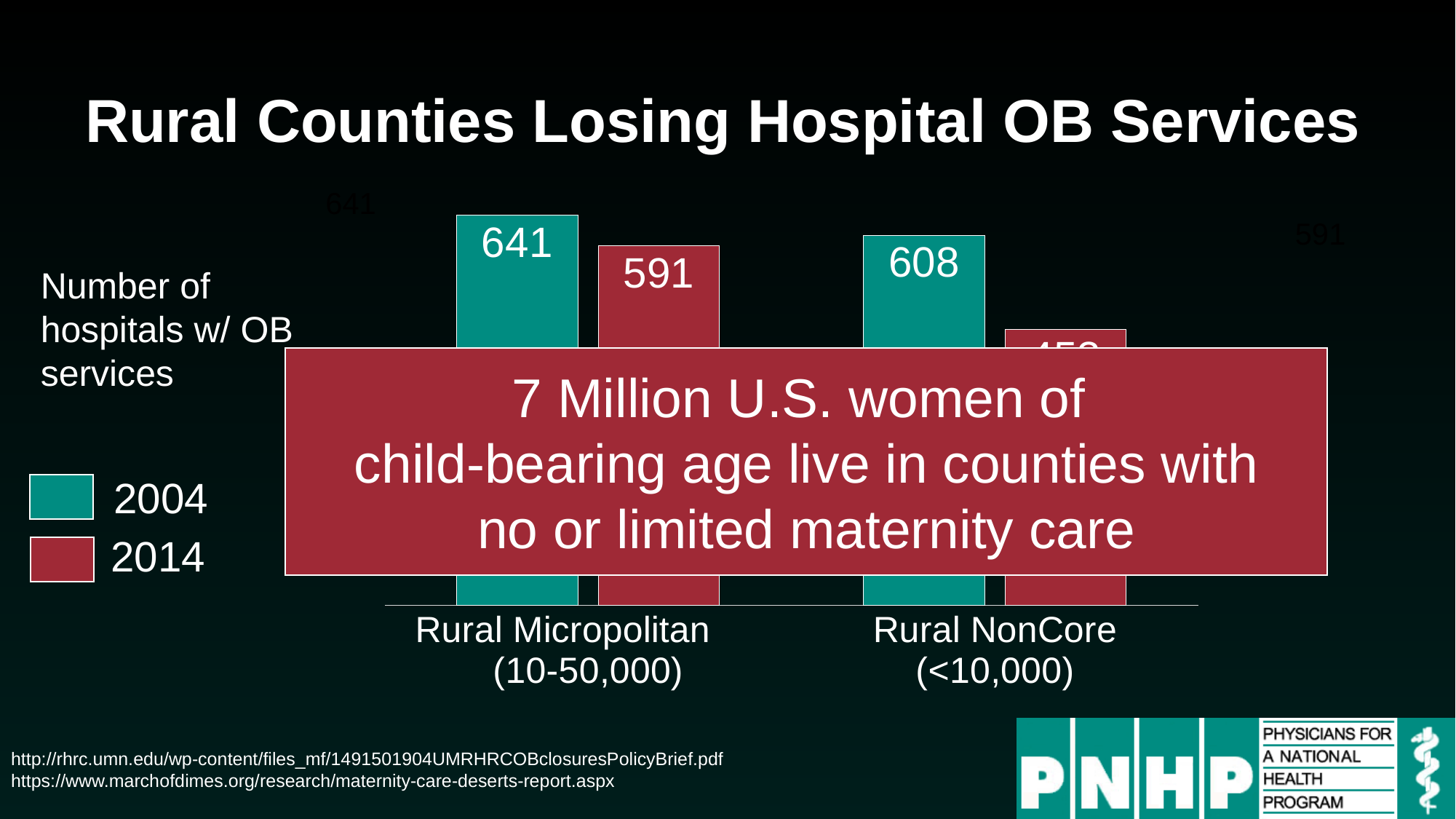
Which bar in the chart is the tallest? Rural Micropolitan, 2004 (641) For Rural NonCore counties, which year has the higher number of hospitals with OB services, 2004 or 2014? 2004 How many series does the chart's legend list? 2 By how much did the number of hospitals with OB services in Rural Micropolitan counties fall from 2004 to 2014? 50 In 2004, which county type had more hospitals with OB services, Rural Micropolitan or Rural NonCore? Rural Micropolitan How many hospitals with OB services did Rural Micropolitan counties have in 2014? 591 How many hospitals with OB services did Rural NonCore counties have in 2004? 608 How many county categories are shown on the x axis of the chart? 2 For Rural Micropolitan counties, which year has the higher number of hospitals with OB services, 2004 or 2014? 2004 What kind of chart is shown on the slide? Bar chart Which colour represents 2014 in the chart's legend? Red How many hospitals with OB services did Rural Micropolitan counties have in 2004? 641